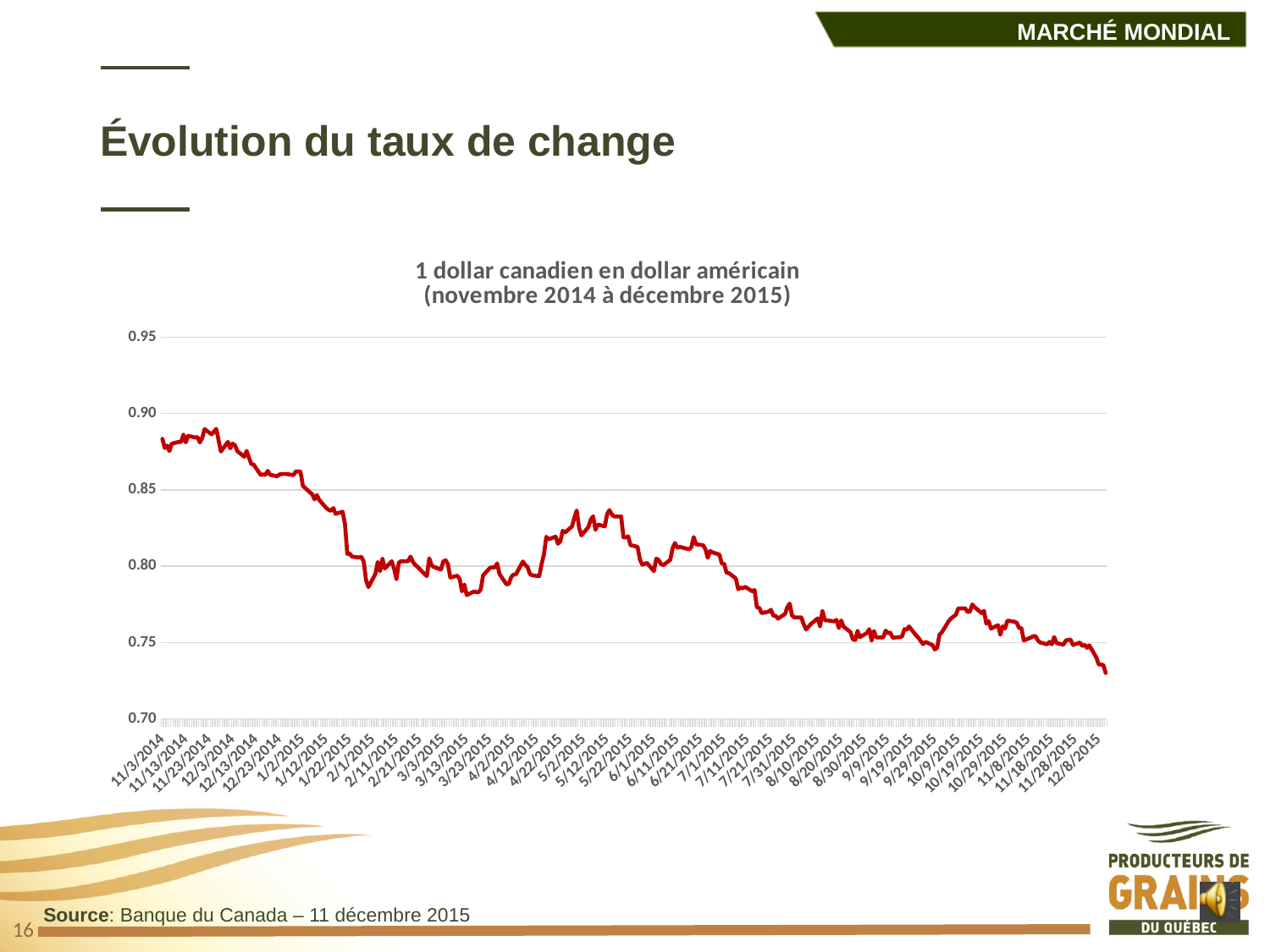
Overall, does the value of the Canadian dollar in US dollars rise or fall from November 2014 to December 2015? fall What kind of chart is shown on the slide? line chart Is the value at 12/8/2015 greater or less than 0.75? less Is the value at 11/3/2014 greater or less than 0.85? greater Is the value at 5/12/2015 greater or less than 0.80? greater What is the highest value shown on the vertical axis? 0.95 What is the title of the chart? 1 dollar canadien en dollar américain (novembre 2014 à décembre 2015) Which is higher, the value at 5/12/2015 or the value at 8/10/2015? 5/12/2015 Which is higher, the value at 11/3/2014 or the value at 12/8/2015? 11/3/2014